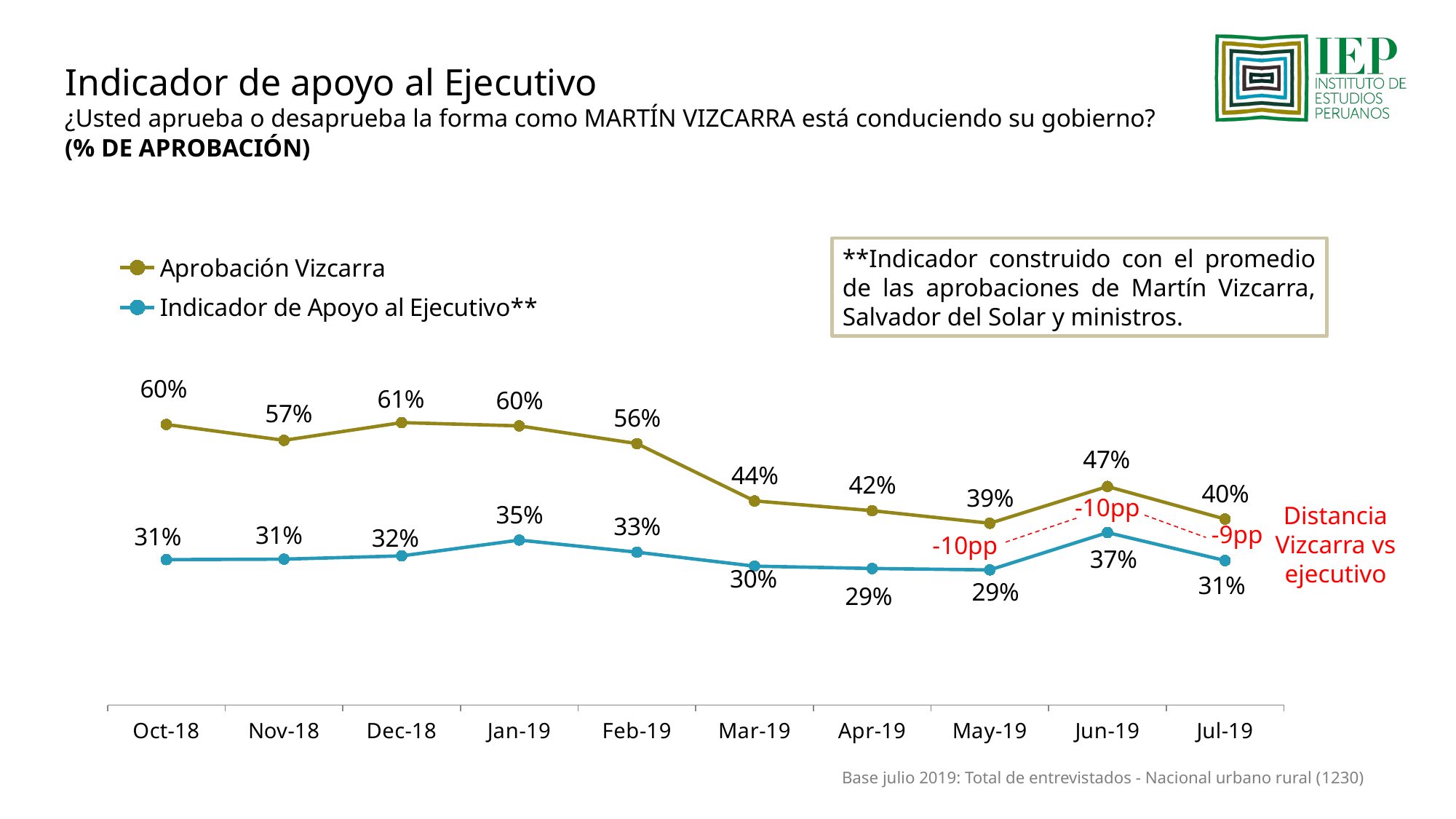
What is the difference between Aprobación Vizcarra and the Indicador de Apoyo al Ejecutivo** in Oct-18? 29pp What is the Indicador de Apoyo al Ejecutivo** value for Jan-19? 35% Which is larger in Jun-19: Aprobación Vizcarra or the Indicador de Apoyo al Ejecutivo**? Aprobación Vizcarra What is the Aprobación Vizcarra value for Jul-19? 40% Does Aprobación Vizcarra rise or fall from Feb-19 to May-19? Fall In which month is the Indicador de Apoyo al Ejecutivo** at its highest? Jun-19 How many months are plotted on the x axis? 10 What kind of chart is shown? Line chart What is the Aprobación Vizcarra value for Dec-18? 61% In which month is Aprobación Vizcarra at its lowest? May-19 How many series does the legend list? 2 What is the 'Distancia Vizcarra vs ejecutivo' shown for Jul-19? -9pp